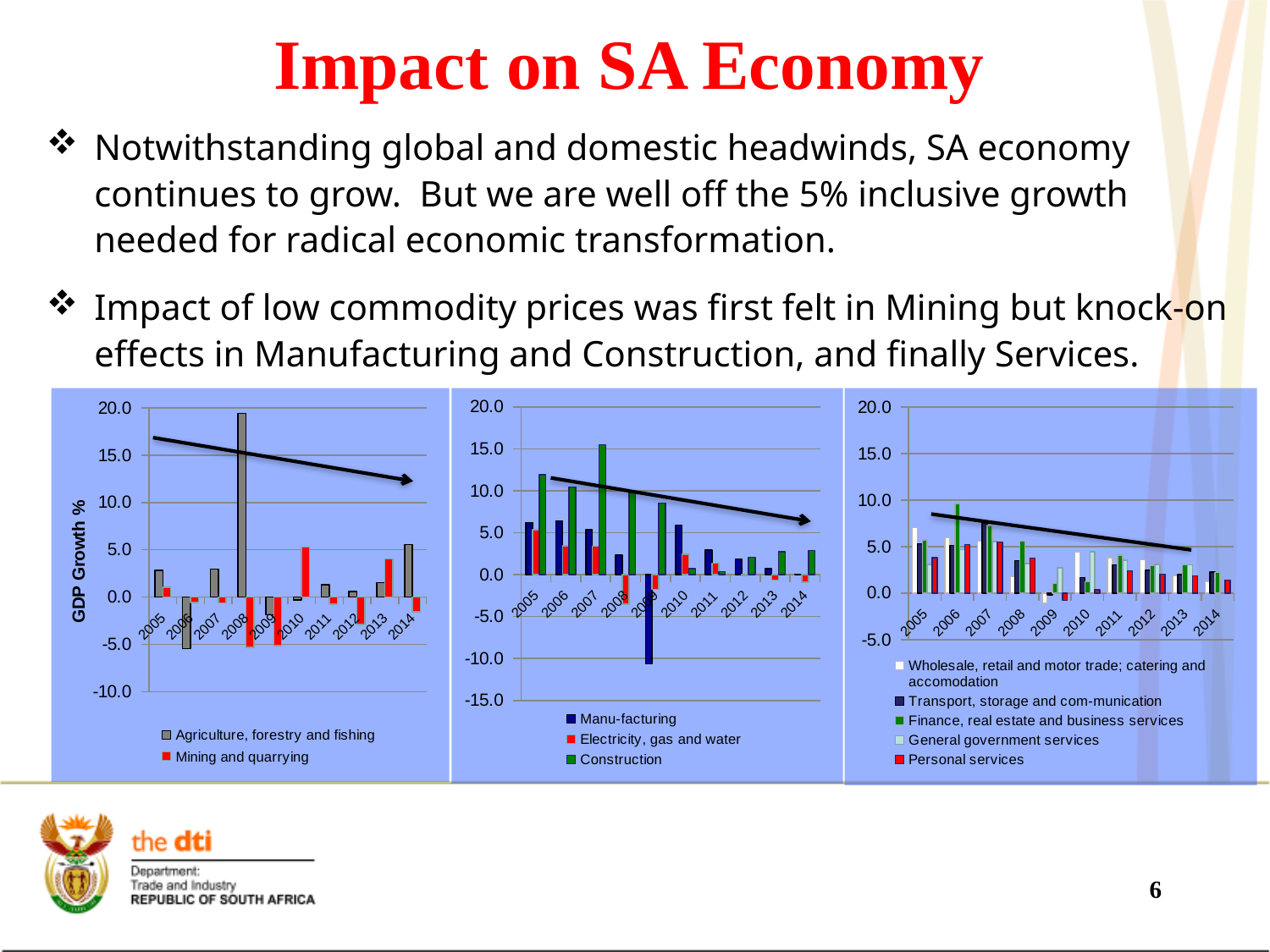
How many series does the legend of the middle chart list? 3 How many series does the legend of the left chart list? 2 In the middle chart, which is larger in 2007: Construction or Manu-facturing? Construction How many series does the legend of the right chart list? 5 In the left chart, is the value for Agriculture, forestry and fishing in 2008 greater or less than 15.0? greater What kind of chart is the left chart on the slide? bar chart What is the y-axis label on the left chart? GDP Growth % In the middle chart, which year has the highest value for Construction? 2007 In the left chart, which year has the highest value for Agriculture, forestry and fishing? 2008 In the middle chart, is the value for Manu-facturing in 2009 greater or less than -5.0? less In the middle chart, which year has the lowest value for Manu-facturing? 2009 How many years are shown on the x axis of the middle chart? 10